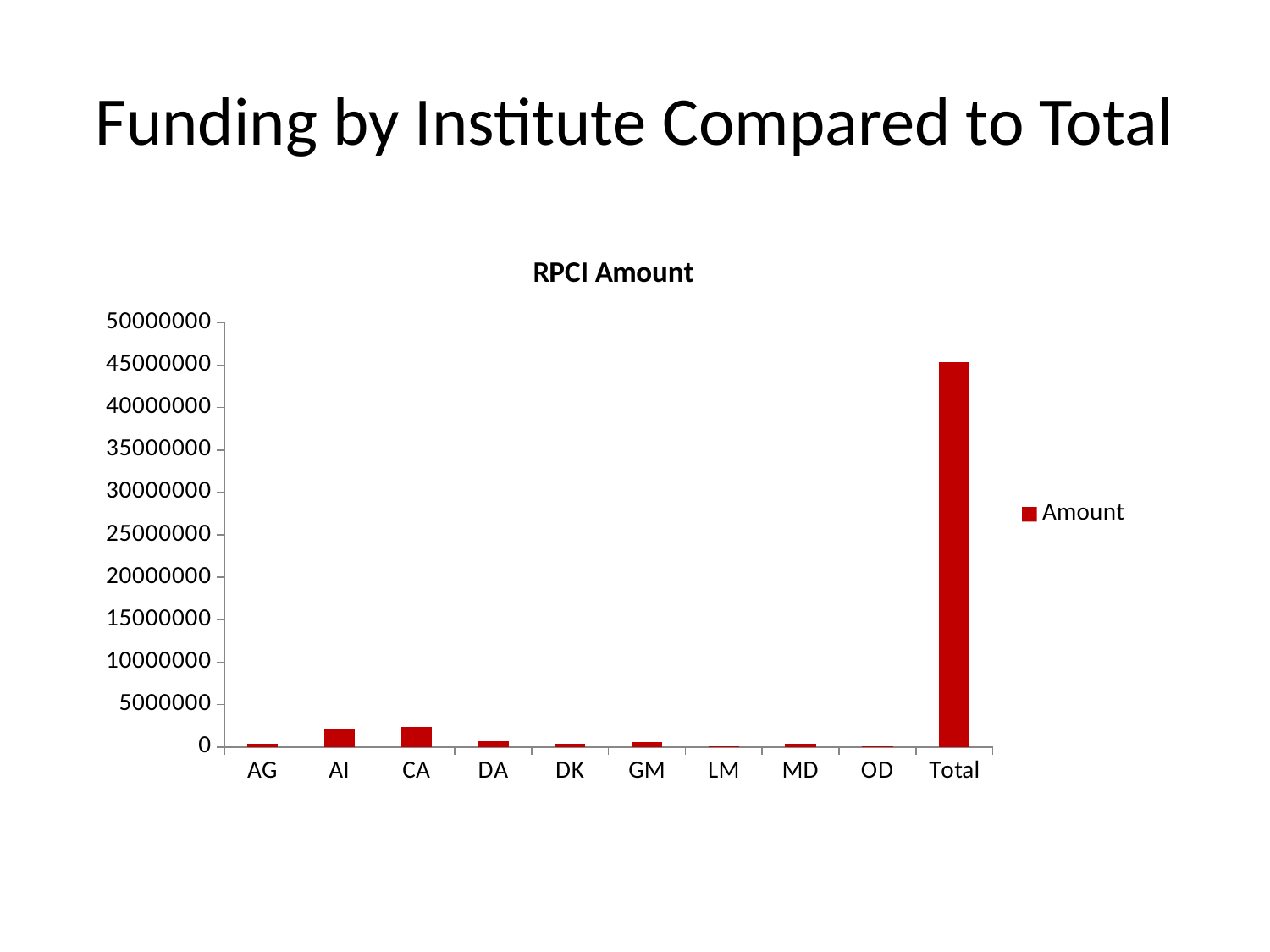
Which is larger, the value for Total or the value for CA? Total Which is larger, the value for AI or the value for DA? AI Is the value for AI greater or less than 5000000? less Is the value for Total greater or less than 40000000? greater Is the value for Total greater or less than 50000000? less What is the name of the series shown in the legend? Amount Which category has the highest bar? Total How many series does the legend list? 1 What is the title of the chart? RPCI Amount What type of chart is shown on the slide? bar chart How many categories are shown on the x axis? 10